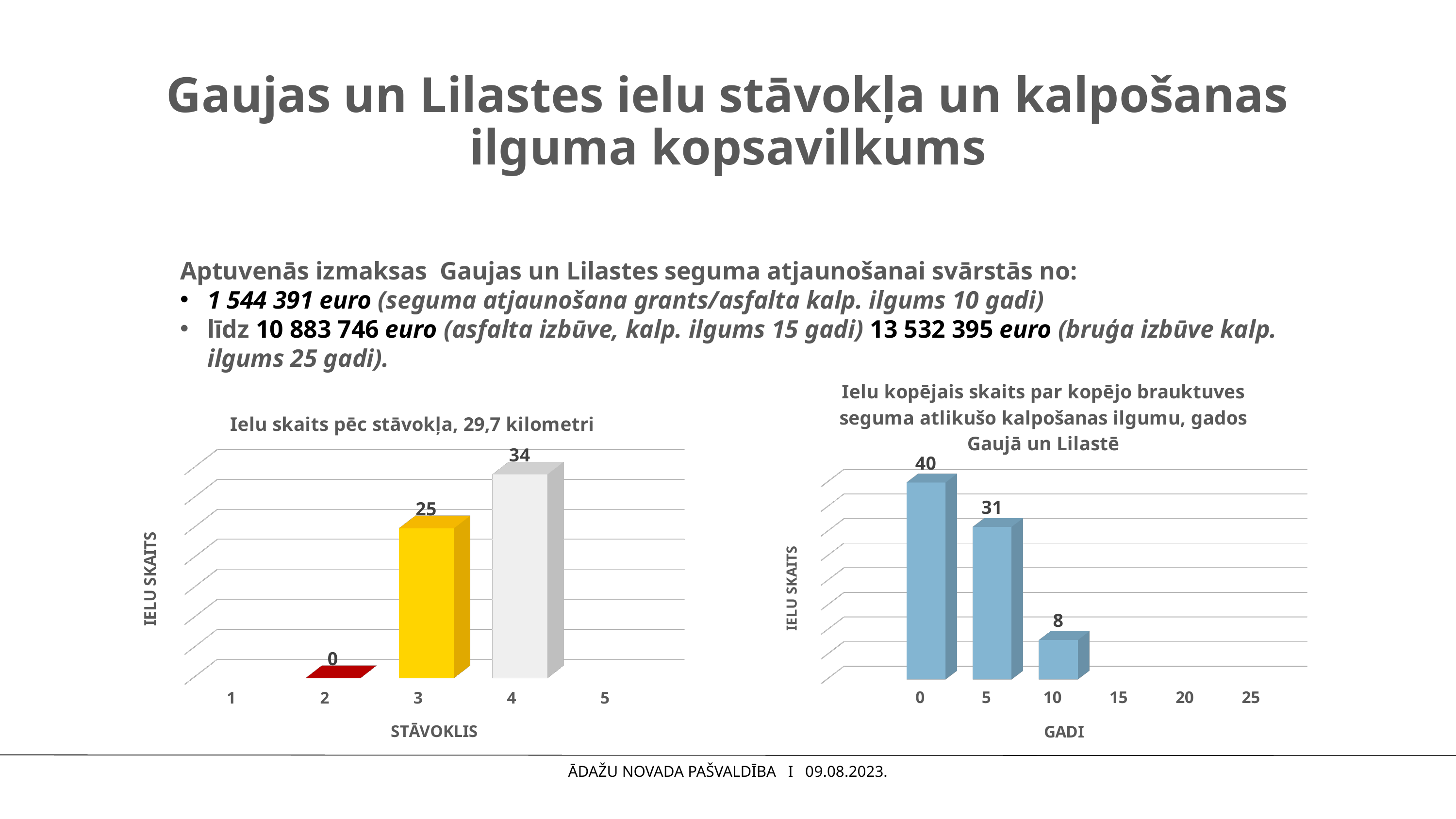
In the right chart 'Ielu kopējais skaits par kopējo brauktuves seguma atlikušo kalpošanas ilgumu', which is larger, the value for 5 gadi or the value for 10 gadi? 5 gadi In the right chart 'Ielu kopējais skaits par kopējo brauktuves seguma atlikušo kalpošanas ilgumu', what is the difference between the values for 0 gadi and 5 gadi? 9 What kind of chart is the right chart 'Ielu kopējais skaits par kopējo brauktuves seguma atlikušo kalpošanas ilgumu'? bar chart In the left chart 'Ielu skaits pēc stāvokļa, 29,7 kilometri', which stāvoklis category has the highest value? 4 In the left chart 'Ielu skaits pēc stāvokļa, 29,7 kilometri', what is the difference between the values for stāvoklis 4 and stāvoklis 3? 9 In the left chart 'Ielu skaits pēc stāvokļa, 29,7 kilometri', what is the value for stāvoklis 2? 0 In the right chart 'Ielu kopējais skaits par kopējo brauktuves seguma atlikušo kalpošanas ilgumu', what is the value for 10 gadi? 8 In the left chart 'Ielu skaits pēc stāvokļa, 29,7 kilometri', what is the value for stāvoklis 4? 34 In the left chart 'Ielu skaits pēc stāvokļa, 29,7 kilometri', what is the value for stāvoklis 3? 25 In the right chart 'Ielu kopējais skaits par kopējo brauktuves seguma atlikušo kalpošanas ilgumu', what is the value for 0 gadi? 40 In the right chart 'Ielu kopējais skaits par kopējo brauktuves seguma atlikušo kalpošanas ilgumu', do the values rise or fall from 0 gadi to 10 gadi? fall In the left chart 'Ielu skaits pēc stāvokļa, 29,7 kilometri', how many categories are labelled on the x axis? 5